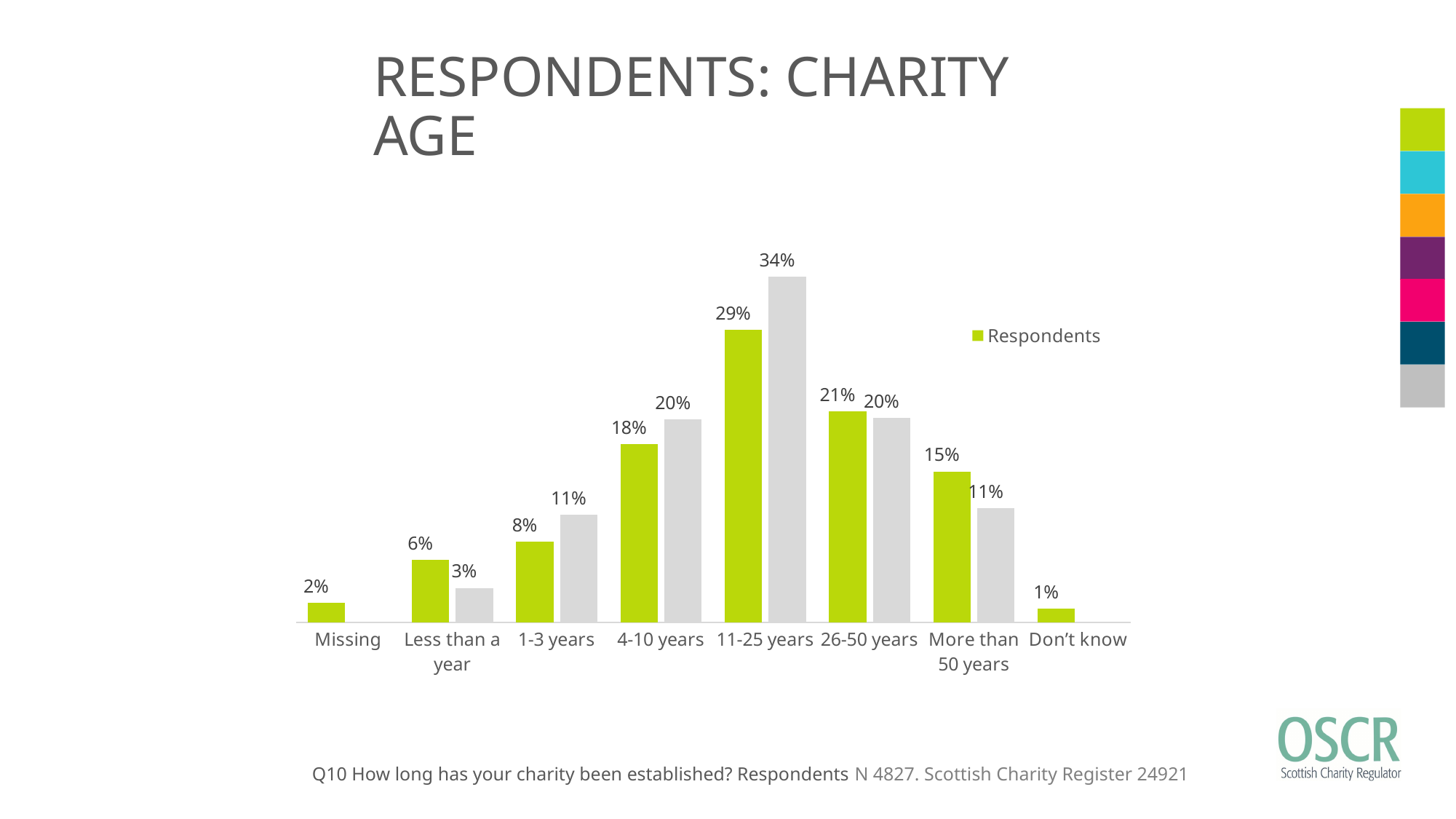
What kind of chart is shown on the slide? Bar chart What is the Respondents value for the Don't know category? 1% What is the Respondents value for the More than 50 years category? 15% What is the title of the slide? RESPONDENTS: CHARITY AGE What is the difference between the Respondents values for 11-25 years and 26-50 years? 8% Which has a larger Respondents value: 1-3 years or Less than a year? 1-3 years What percentage of Respondents have a charity age of 11-25 years? 29% Which category has the lowest Respondents value? Don't know Which category has the highest Respondents value? 11-25 years How many series does the legend list? 1 How many categories are shown on the x axis? 8 What is the Respondents value for the 4-10 years category? 18%